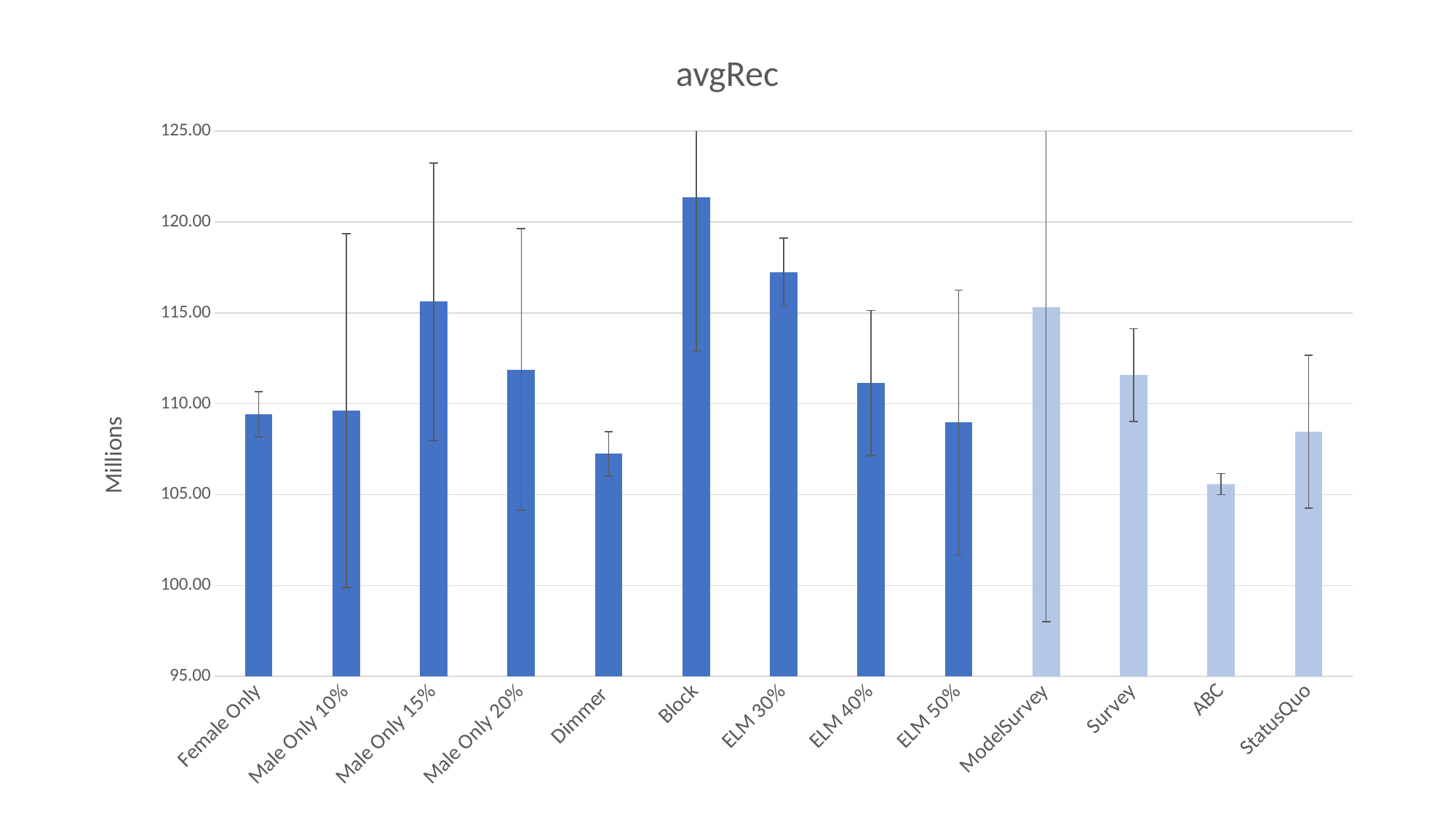
What is the label on the vertical axis of the chart? Millions How many categories are shown on the x axis of the chart? 13 What kind of chart is shown on the slide? bar chart Which has the larger value, ELM 30% or ELM 40%? ELM 30% Which has the larger value, Male Only 15% or Male Only 20%? Male Only 15% Is the value for Block greater or less than 120.00? greater Is the value for Dimmer greater or less than 110.00? less Is the value for ELM 30% greater or less than 115.00? greater Which category has the highest value in the chart? Block What is the title of the chart? avgRec Which category has the lowest value in the chart? ABC